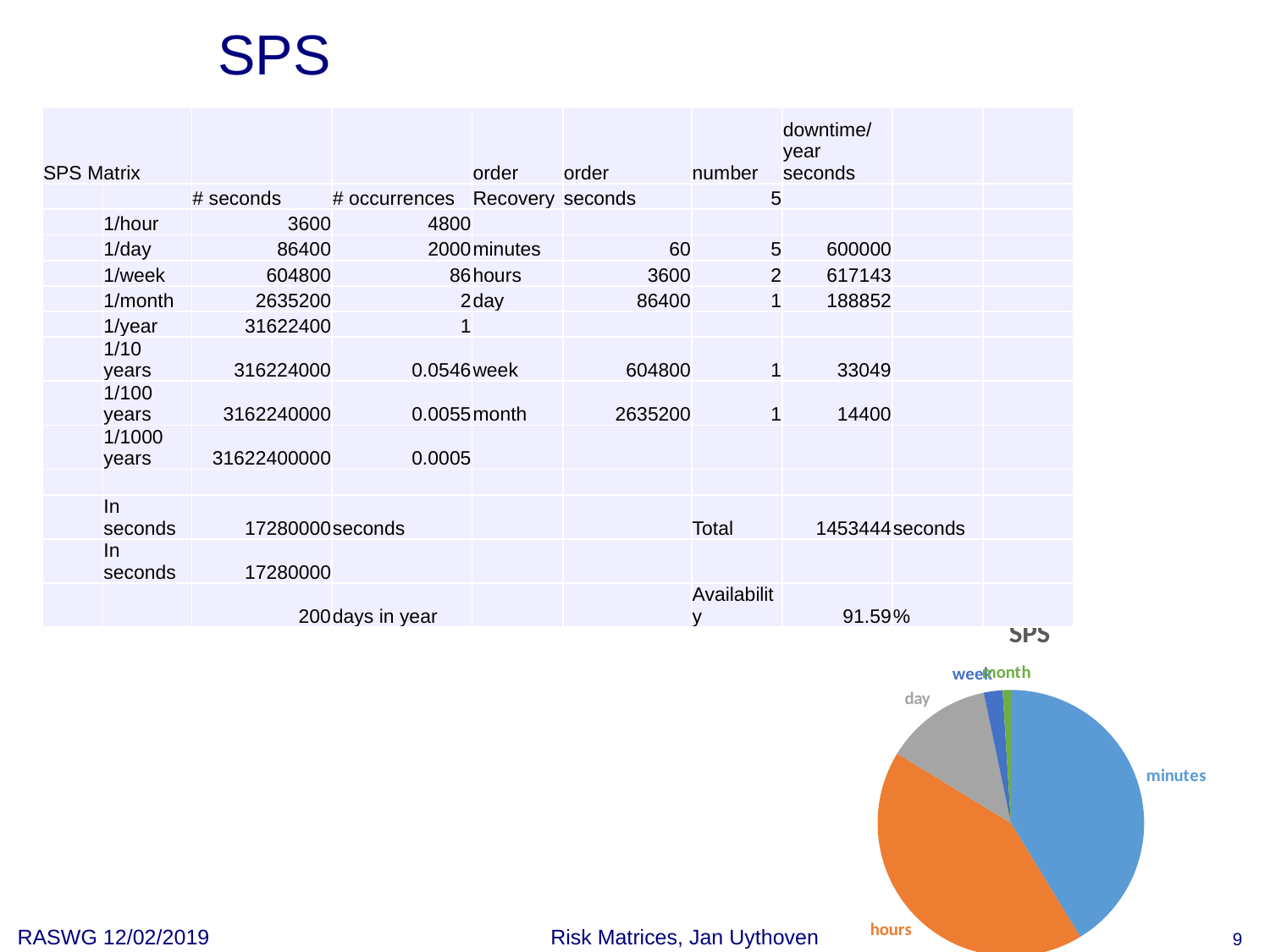
What is the title of the pie chart? SPS In the pie chart, which slice is larger, minutes or day? minutes How many slices does the pie chart have? 5 What kind of chart is shown at the bottom right of the slide? pie chart In the pie chart, which slice is larger, hours or week? hours In the pie chart, which slice is larger, day or month? day What colour is the hours slice in the pie chart? orange Which slice of the pie chart is the smallest? month